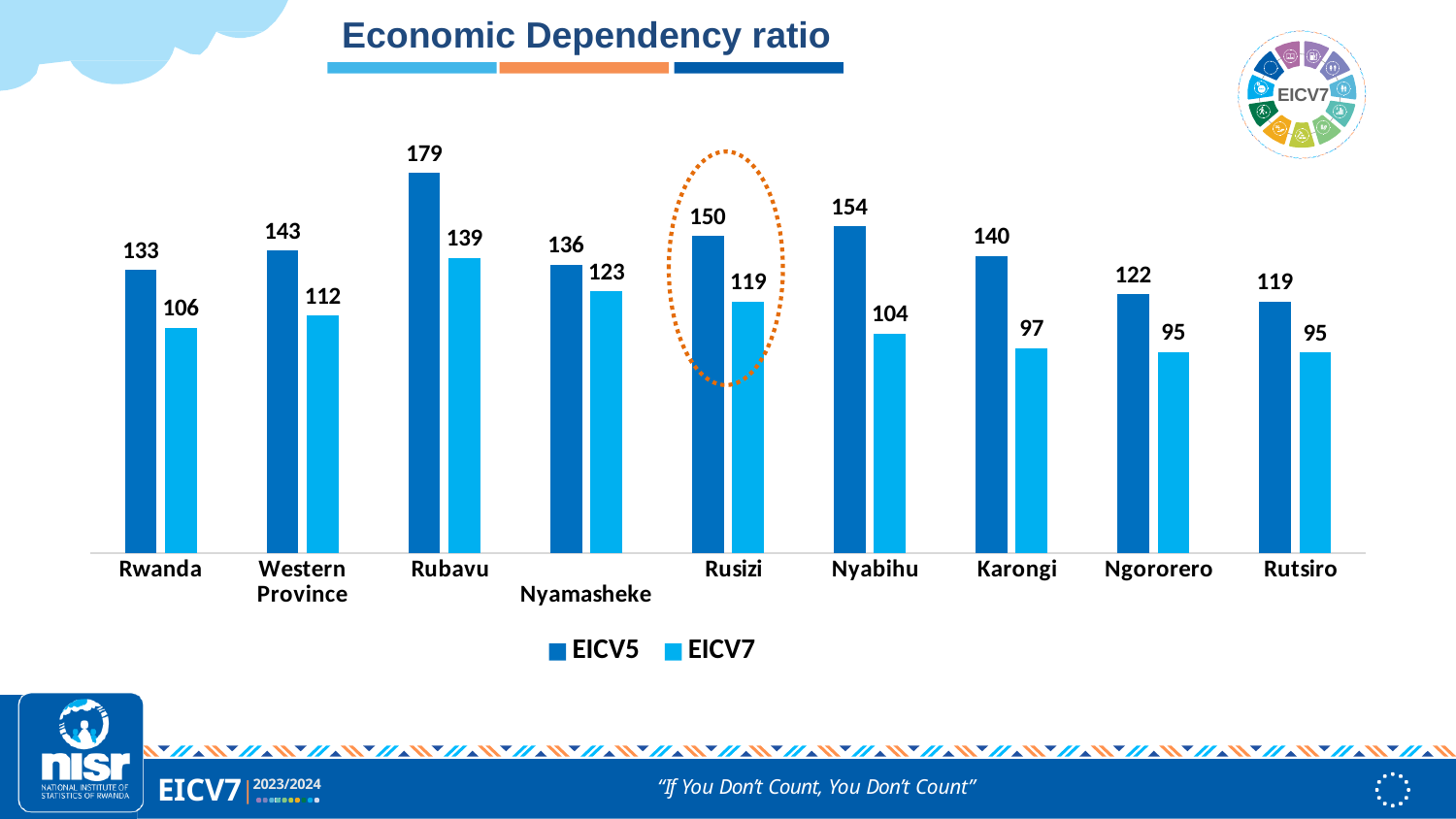
What is the difference between the EICV5 and EICV7 values for Nyabihu? 50 What is the EICV7 value for Nyamasheke? 123 How many categories are shown on the x axis? 9 What is the EICV7 value for Rusizi? 119 Which is larger, the EICV7 value for Western Province or the EICV7 value for Rwanda? Western Province How many series does the legend list? 2 Which category has the lowest EICV5 value? Rutsiro What is the EICV5 value for Karongi? 140 Which category has the highest EICV7 value? Rubavu Which category has the highest EICV5 value? Rubavu What is the EICV5 value for Rubavu? 179 What type of chart is shown on the slide? Bar chart